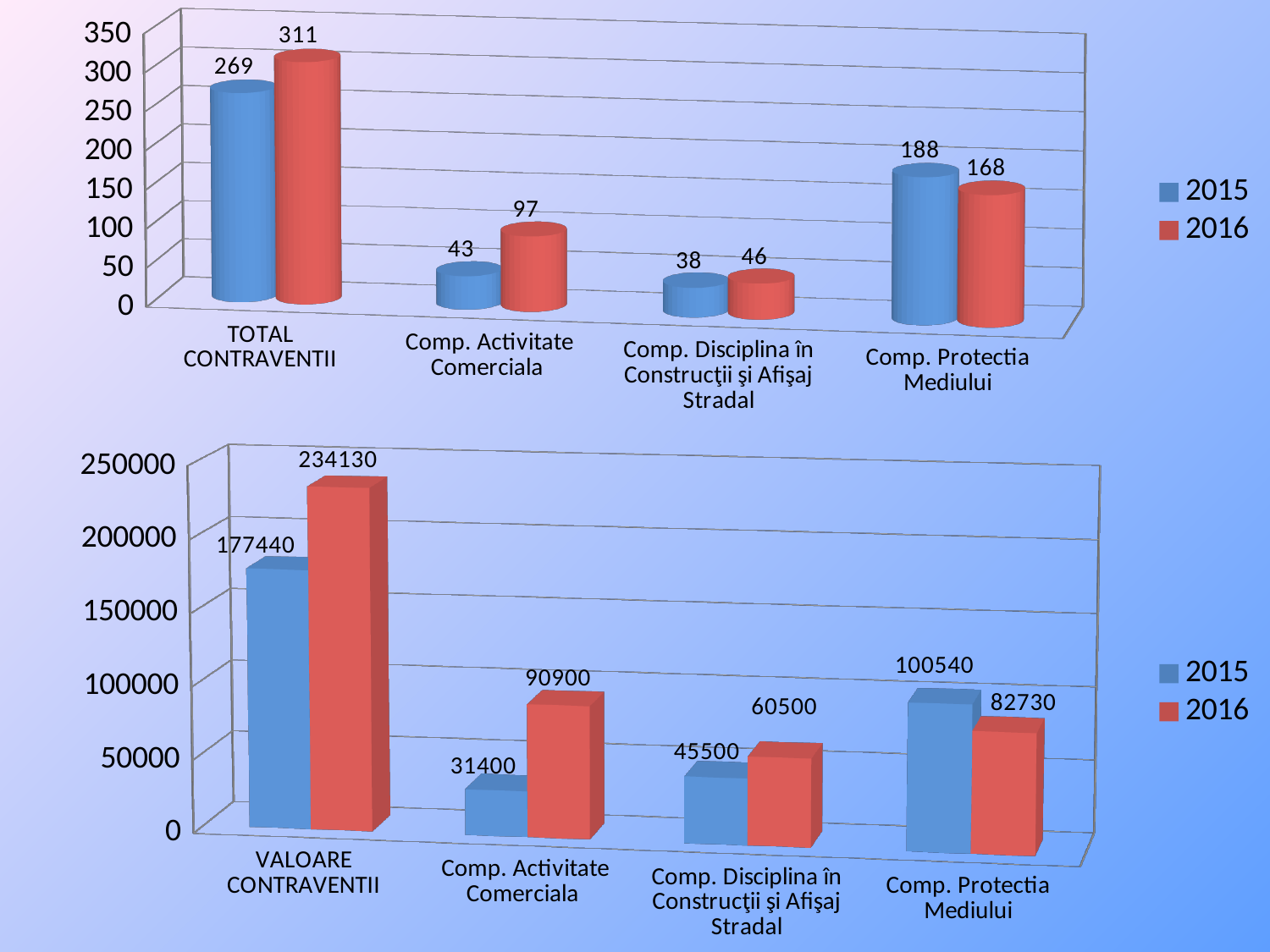
In the top chart, is the 2015 or 2016 value larger for Comp. Protectia Mediului? 2015 In the top chart, what is the 2015 value for Comp. Protectia Mediului? 188 In the bottom chart, what is the 2015 value for Comp. Disciplina în Construcţii şi Afişaj Stradal? 45500 In the top chart, what is the difference between the 2016 and 2015 values for Comp. Activitate Comerciala? 54 What kind of chart is the bottom chart? Bar chart How many categories are shown on the x axis of the bottom chart? 4 In the bottom chart, what is the 2016 value for VALOARE CONTRAVENTII? 234130 In the top chart, what is the 2016 value for TOTAL CONTRAVENTII? 311 In the bottom chart, which category has the lowest 2016 value? Comp. Disciplina în Construcţii şi Afişaj Stradal In the bottom chart, what is the difference between the 2015 and 2016 values for Comp. Protectia Mediului? 17810 In the top chart, which category has the lowest 2015 value? Comp. Disciplina în Construcţii şi Afişaj Stradal In the top chart, how many series does the legend list? 2